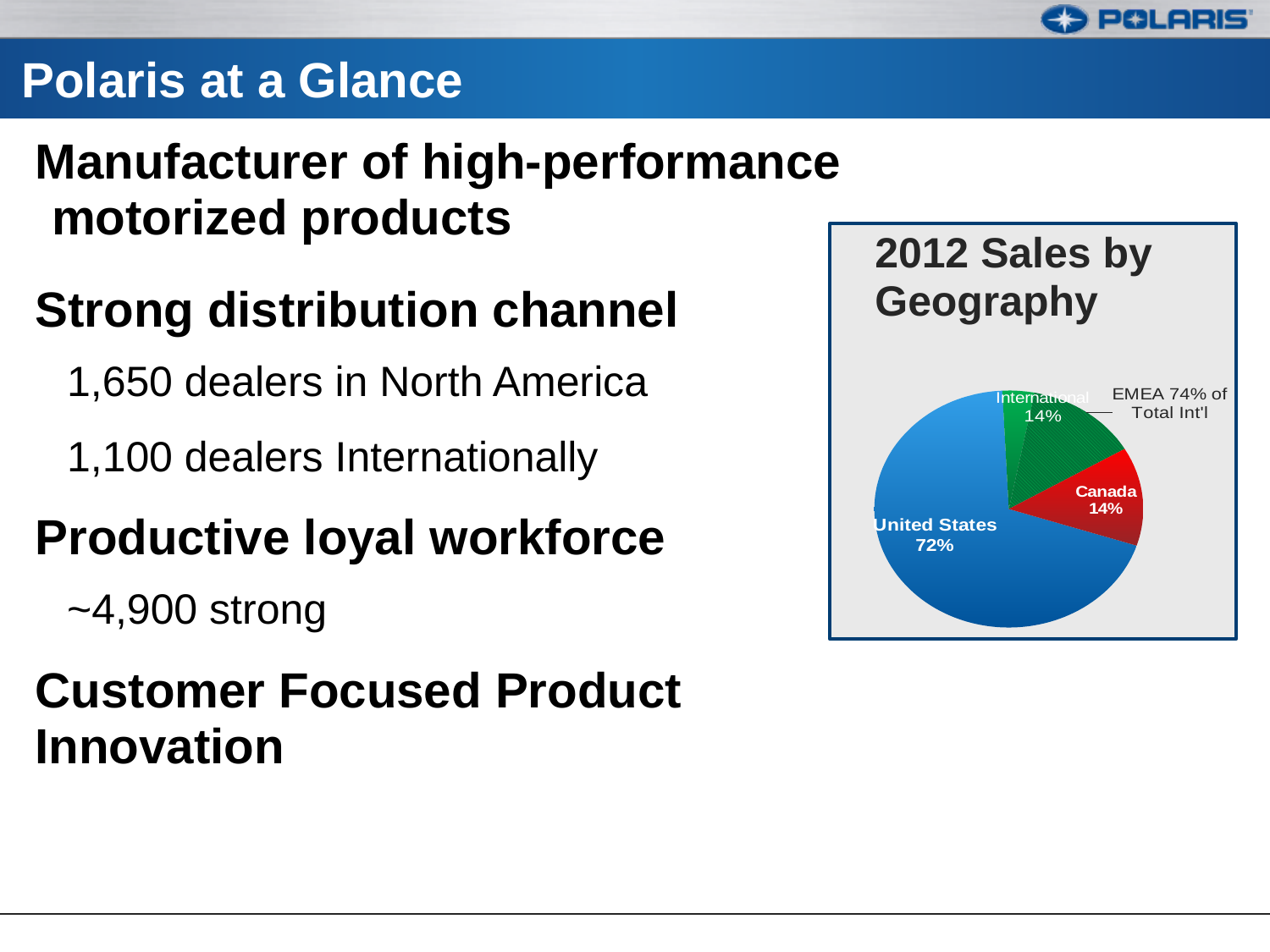
Which geography has the largest share of 2012 sales? United States How many slices does the pie chart have? 4 What share of 2012 sales came from International? 14% Is the United States share greater or less than 50%? greater What share of 2012 sales came from the United States? 72% What colour is the United States slice? blue What kind of chart is shown on the slide? pie chart What is the difference in percentage points between the United States share and the Canada share? 58 What is the title of the chart? 2012 Sales by Geography According to the annotation, what percentage of Total Int'l sales does EMEA represent? 74% What share of 2012 sales came from Canada? 14% Which is larger, the United States share or the International share? United States